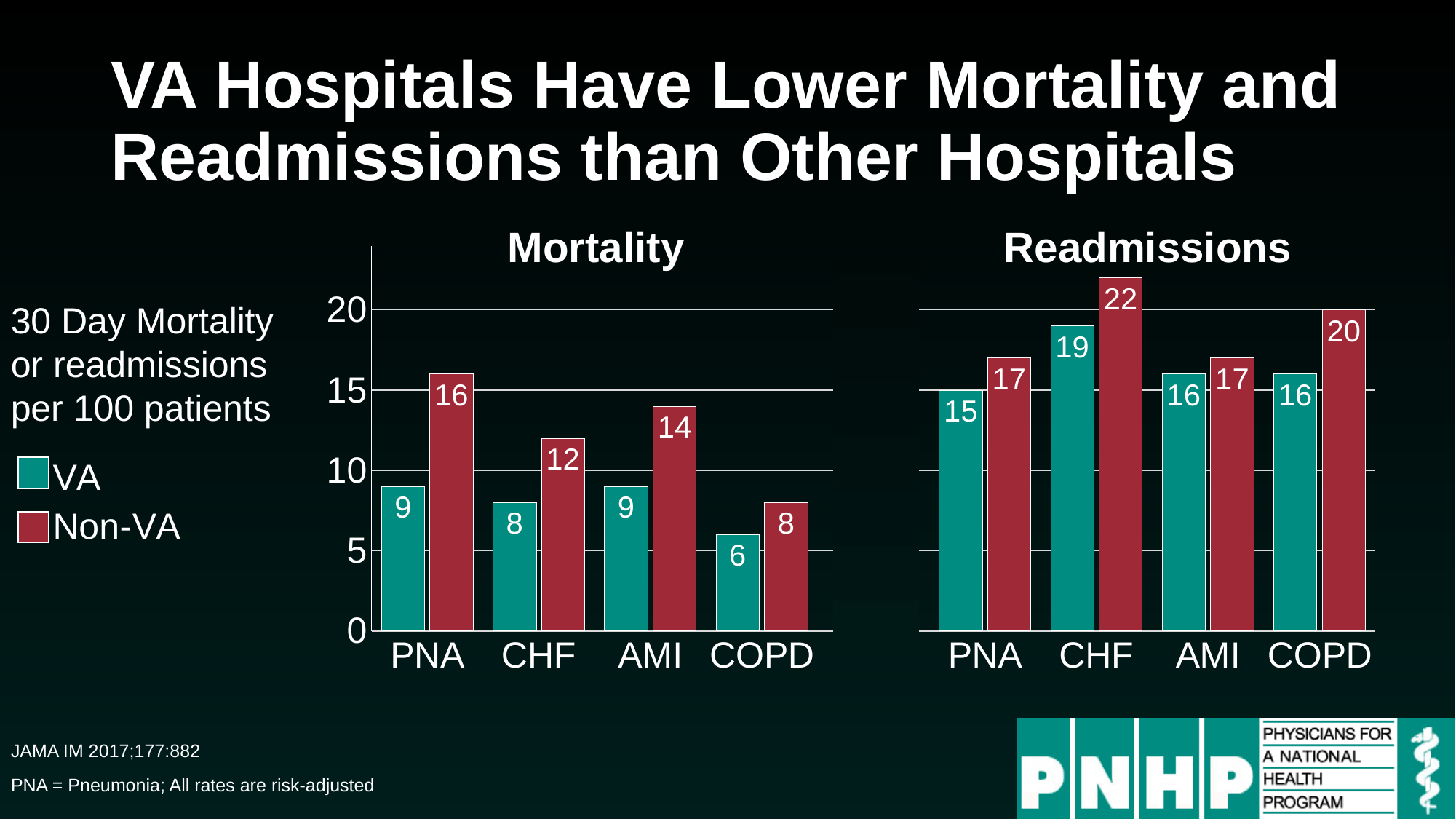
In the Mortality chart, what is the VA value for COPD? 6 What kind of chart is the Mortality chart? Bar chart How many series does the legend list? 2 In the Readmissions chart, what is the difference between the Non-VA and VA values for COPD? 4 In the Mortality chart, what is the Non-VA value for PNA? 16 Which colour represents the VA series in the legend? Teal How many categories are shown on the x axis of the Readmissions chart? 4 In the Mortality chart, what is the difference between the Non-VA and VA values for PNA? 7 In the Readmissions chart, which category has the highest Non-VA value? CHF In the Mortality chart, which category has the lowest VA value? COPD In the Mortality chart, which is larger for AMI: the VA value or the Non-VA value? Non-VA In the Readmissions chart, what is the VA value for CHF? 19